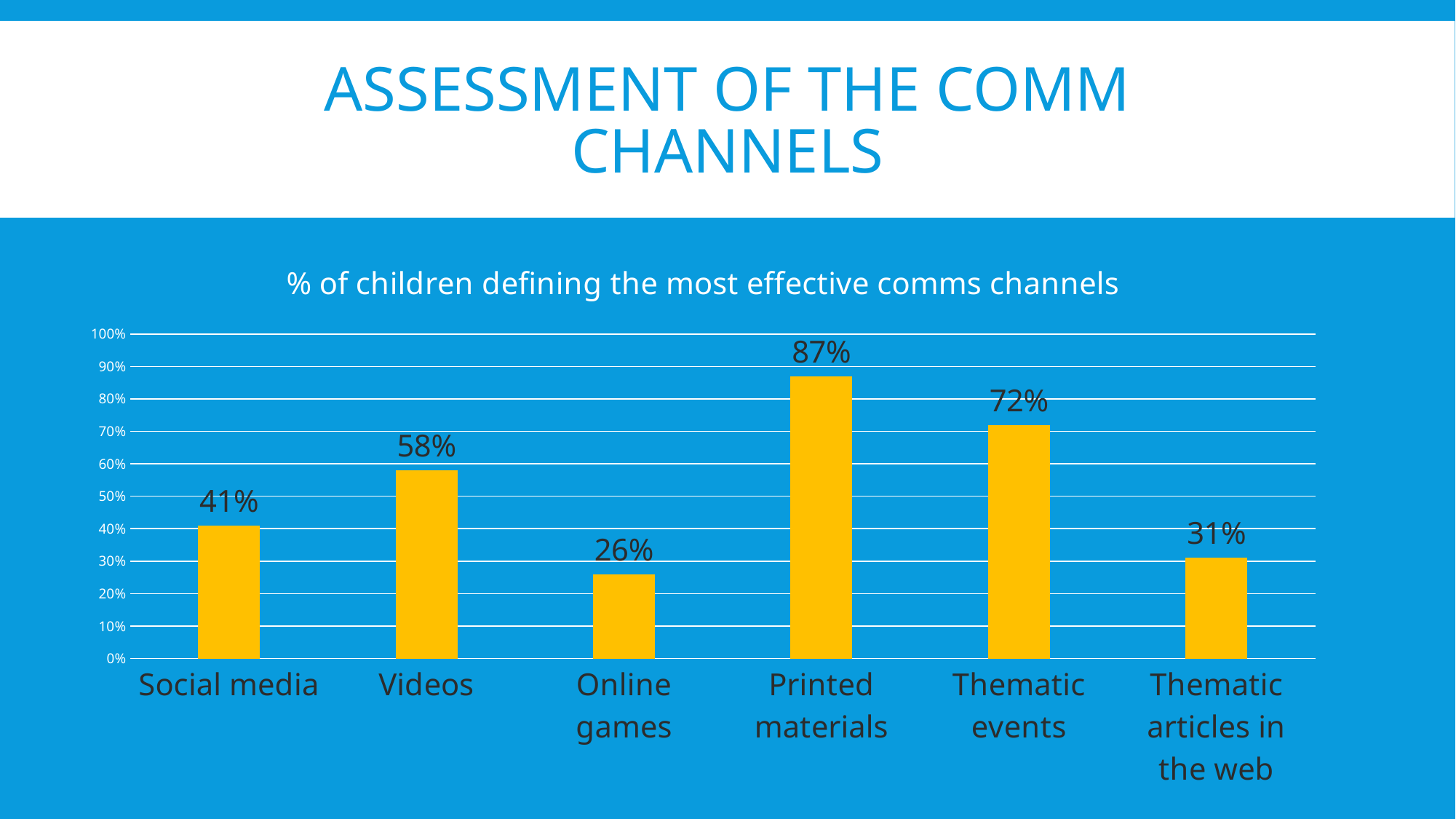
What type of chart is shown on the slide? Bar chart What is the title of the chart? % of children defining the most effective comms channels Is the value for Thematic events greater or less than 60%? greater What is the value shown for Thematic articles in the web? 31% What is the value shown for Online games? 26% Which has a higher value, Social media or Thematic articles in the web? Social media What percentage of children chose Printed materials as the most effective comms channel? 87% What is the difference between the values for Videos and Social media? 17% How many comms channels are shown on the chart? 6 Which comms channel has the highest percentage? Printed materials What is the difference between the values for Printed materials and Thematic events? 15% Which comms channel has the lowest percentage? Online games